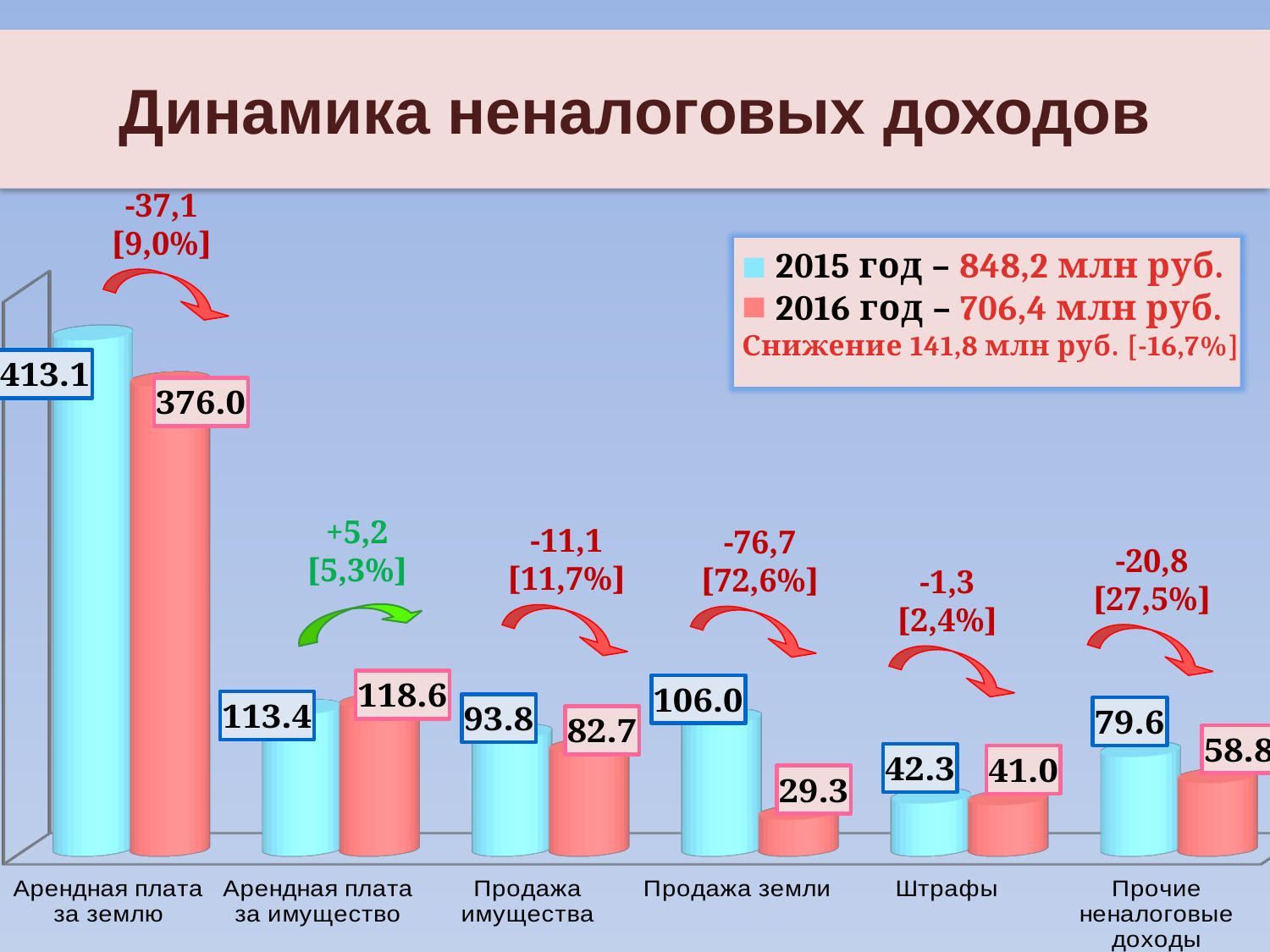
What kind of chart is shown on the slide? bar chart For Арендная плата за имущество, which is larger: the 2015 value or the 2016 value? 2016 Which category has the highest 2015 value? Арендная плата за землю What is the 2016 value for Арендная плата за имущество? 118.6 What is the 2016 value for Прочие неналоговые доходы? 58.8 What is the 2015 value for Продажа земли? 106.0 Which category has the lowest 2016 value? Продажа земли How many series does the legend list? 2 What is the difference between the 2015 and 2016 values for Продажа земли? 76.7 What is the difference between the 2015 and 2016 values for Арендная плата за землю? 37.1 According to the legend, what is the total for 2016 год? 706,4 млн руб. How many categories are shown on the x axis? 6